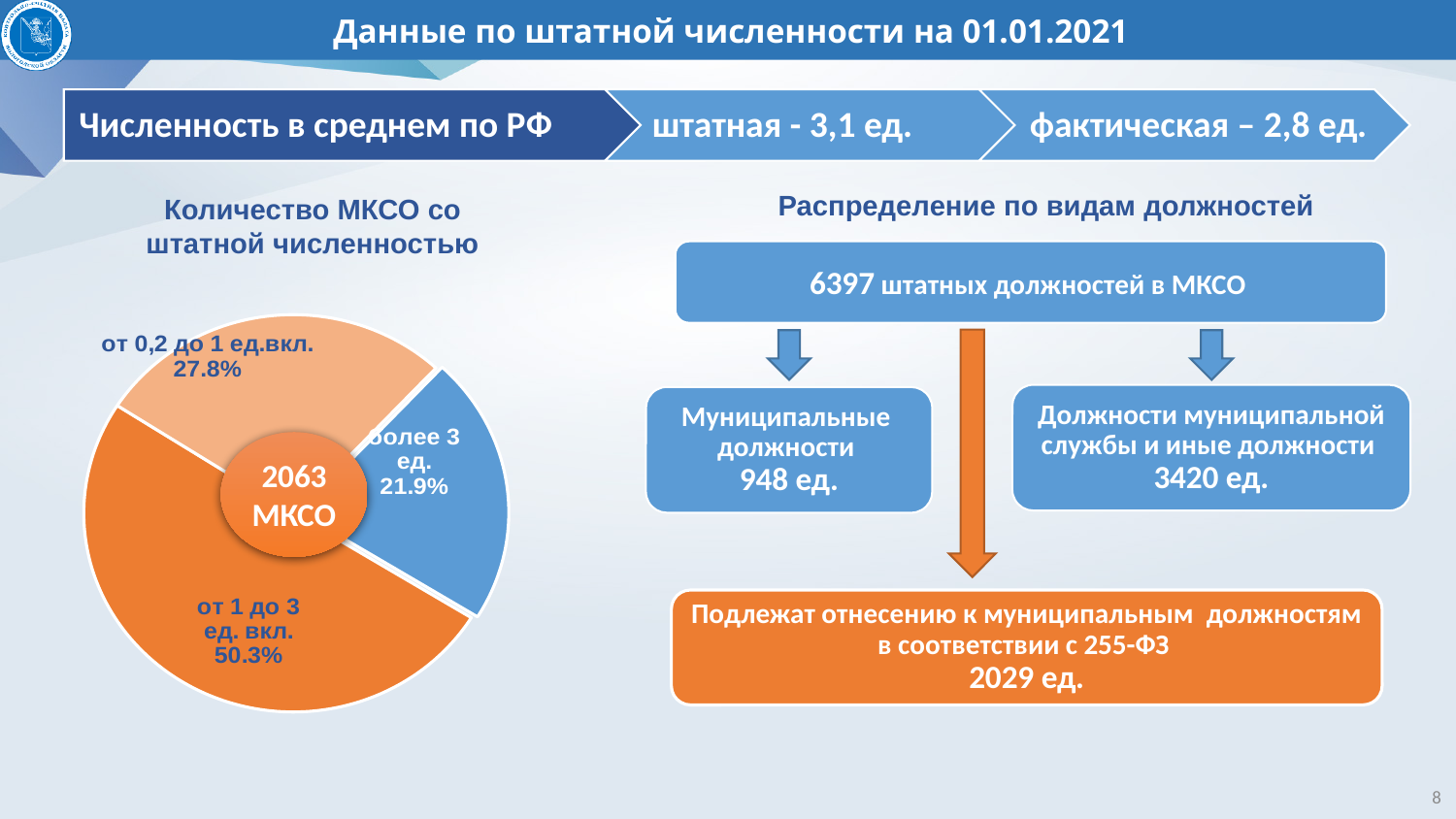
Which slice of the pie chart is the largest? от 1 до 3 ед. вкл. What type of chart is shown on the slide? pie chart What is the difference in percentage points between the "от 0,2 до 1 ед.вкл." slice and the "более 3 ед." slice? 5.9 What is the title of the pie chart? Количество МКСО со штатной численностью What is the difference in percentage points between the "от 1 до 3 ед. вкл." slice and the "от 0,2 до 1 ед.вкл." slice? 22.5 Which is larger in the pie chart: "от 0,2 до 1 ед.вкл." or "более 3 ед."? от 0,2 до 1 ед.вкл. How many slices does the pie chart have? 3 Which slice of the pie chart is the smallest? более 3 ед. What share of the pie does the slice "от 1 до 3 ед. вкл." have? 50.3% What share of the pie does the slice "более 3 ед." have? 21.9% What share of the pie does the slice "от 0,2 до 1 ед.вкл." have? 27.8% What number is shown in the centre of the pie chart? 2063 МКСО